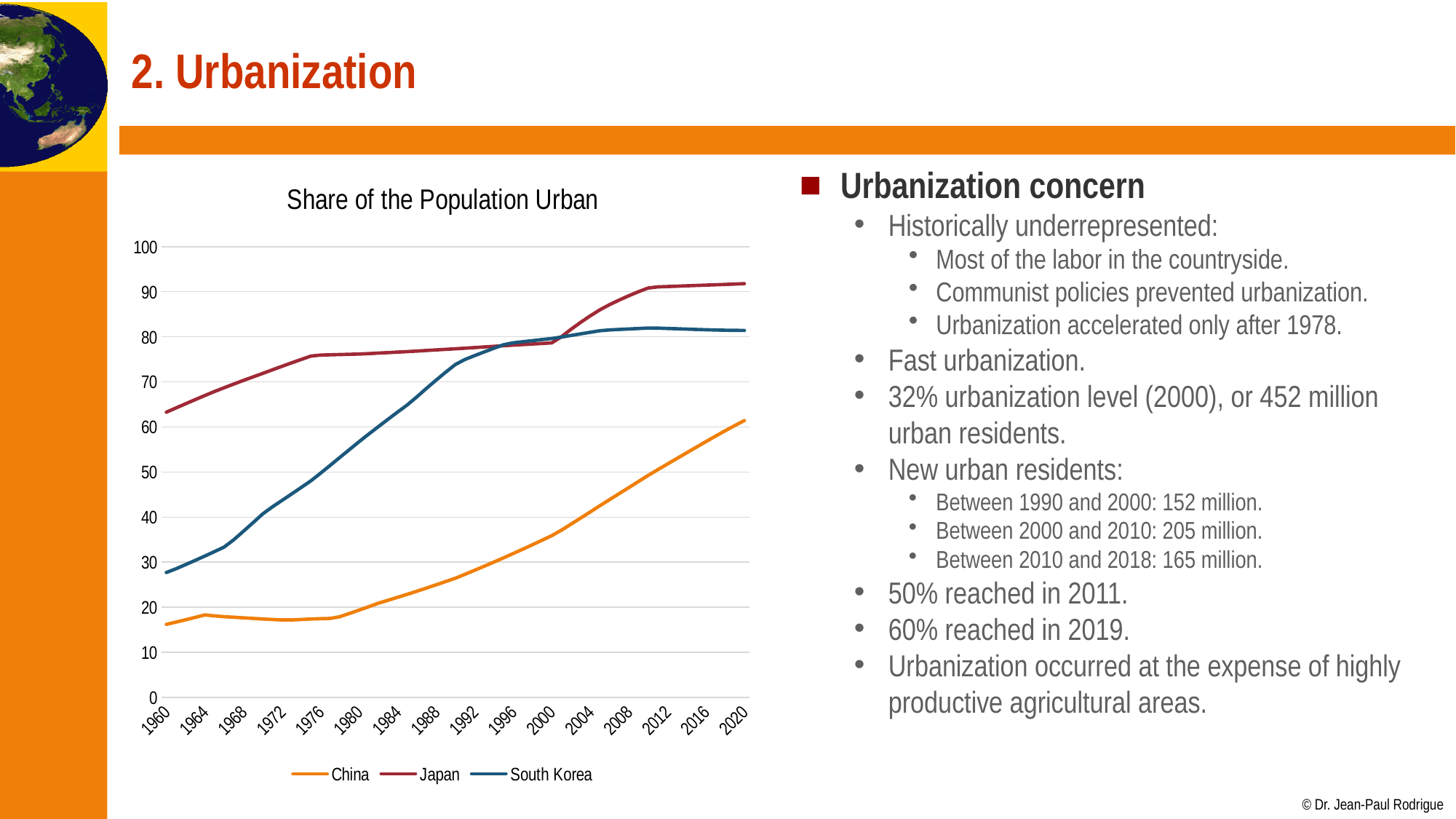
What is the title of the chart? Share of the Population Urban How many year labels are shown along the x axis of the chart? 16 Is the value for China in 1960 greater or less than 20? less In 1980, which is larger: the value for South Korea or the value for China? South Korea What kind of chart is shown on the slide? line chart Which country has the highest share of urban population in 2020? Japan Is the value for China in 2000 greater or less than 30? greater Which series is drawn in orange in the chart? China Which country has the lowest share of urban population in 1960? China Does the share of urban population for China rise or fall from 1980 to 2020? rise Is the value for South Korea in 1960 greater or less than 30? less How many series does the legend of the chart list? 3